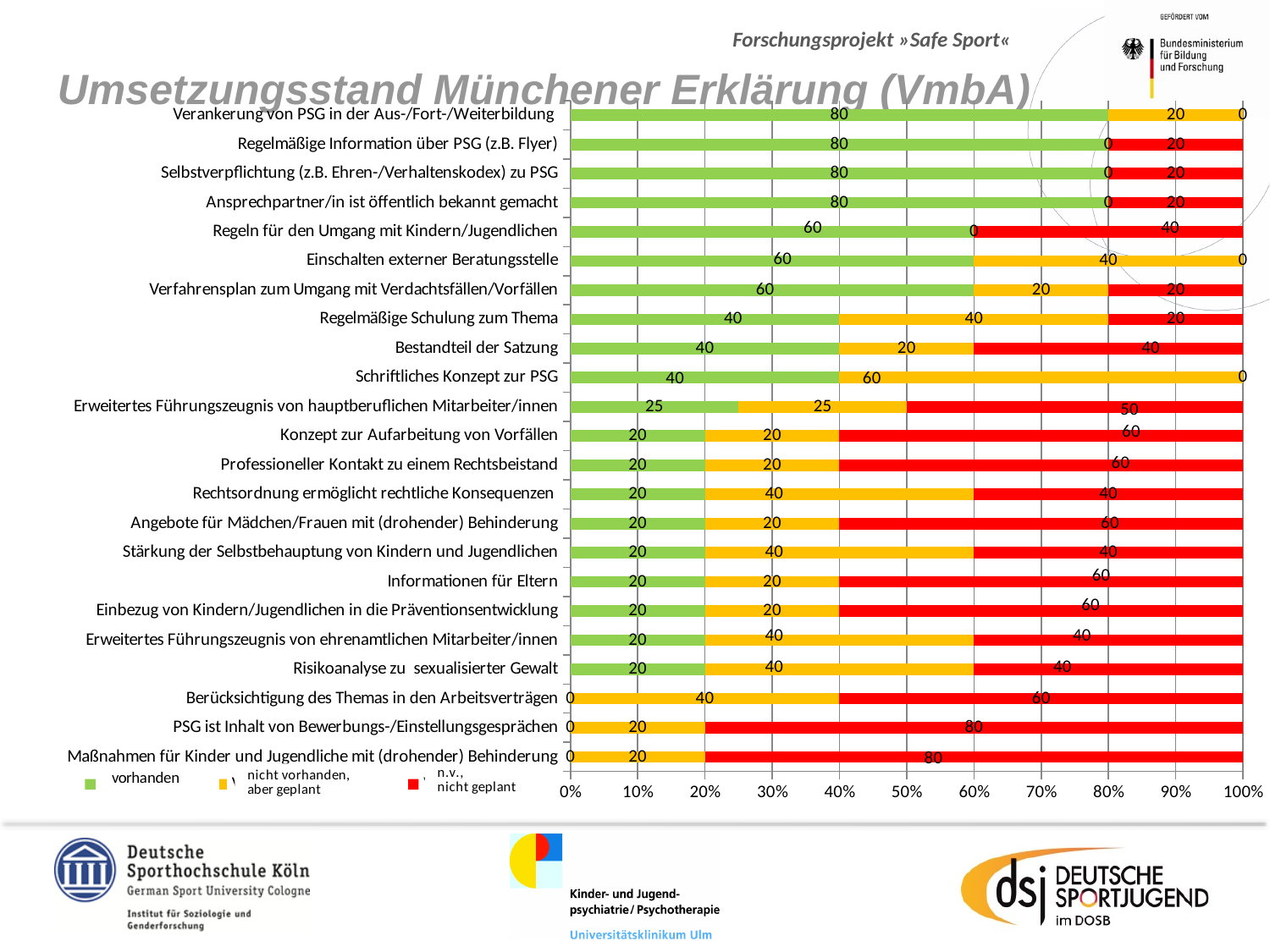
What kind of chart is shown on the slide? Stacked bar chart For 'Risikoanalyse zu sexualisierter Gewalt', what is the difference between the 'n.v., nicht geplant' value and the 'vorhanden' value? 20 Which colour represents the 'n.v., nicht geplant' series? Red For 'Regelmäßige Schulung zum Thema', which is larger: the 'vorhanden' value or the 'n.v., nicht geplant' value? vorhanden What is the total of the stacked bar for 'Bestandteil der Satzung'? 100 What is the 'n.v., nicht geplant' value for 'PSG ist Inhalt von Bewerbungs-/Einstellungsgesprächen'? 80 How many series does the legend list? 3 What is the 'nicht vorhanden, aber geplant' value for 'Schriftliches Konzept zur PSG'? 60 What is the 'vorhanden' value for 'Regeln für den Umgang mit Kindern/Jugendlichen'? 60 How many categories are plotted on the chart? 23 What is the 'vorhanden' value for 'Erweitertes Führungszeugnis von hauptberuflichen Mitarbeiter/innen'? 25 Which category has the highest 'nicht vorhanden, aber geplant' value? Schriftliches Konzept zur PSG